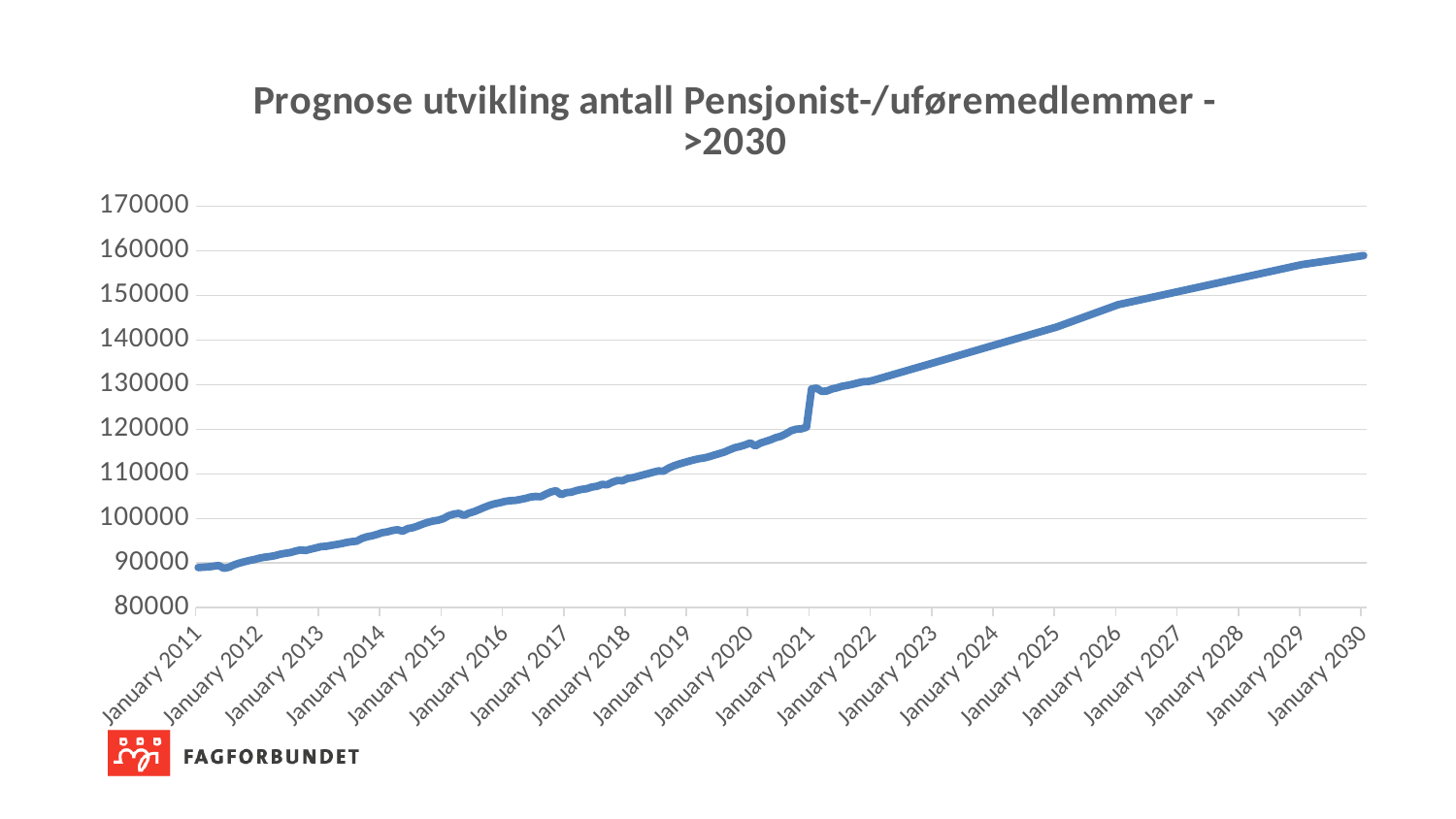
Is the value for January 2026 greater or less than 150000? less What is the title of the chart? Prognose utvikling antall Pensjonist-/uføremedlemmer - >2030 How many year labels are shown on the x axis? 20 Is the value for January 2016 greater or less than 100000? greater What kind of chart is shown on the slide? line chart Is the value for January 2014 greater or less than 90000? greater Do the values generally rise or fall from January 2011 to January 2030? rise Which of the two is larger, the value at January 2030 or the value at January 2011? January 2030 What is the highest value shown on the y axis? 170000